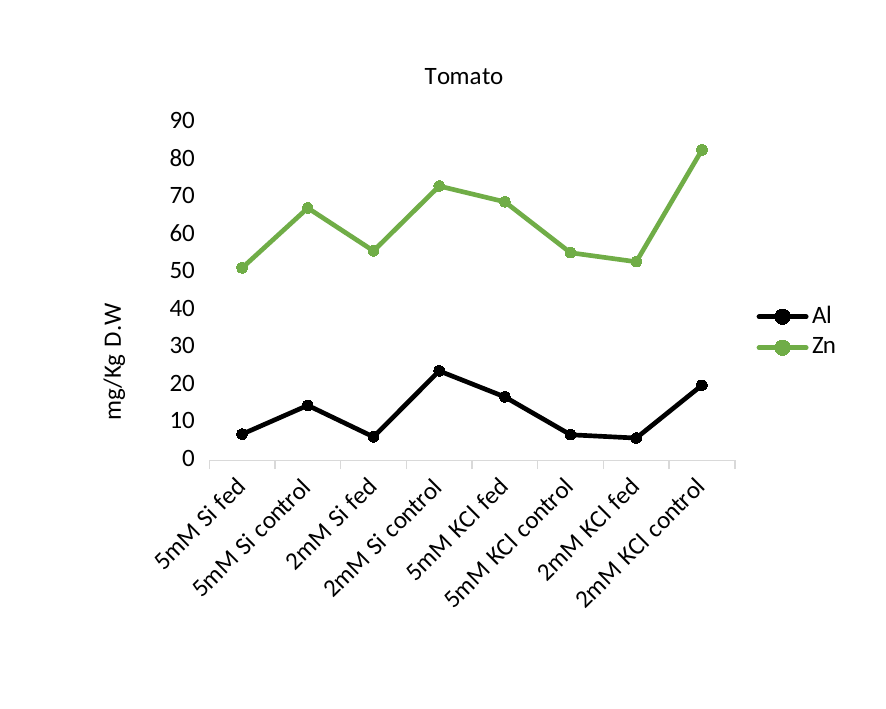
How many series does the legend list? 2 Is the Zn value for 2mM KCl control greater or less than 70? greater For which category is the Al value highest? 2mM Si control Is the Al value for 2mM Si control greater or less than 20? greater Does the Al value rise or fall from 2mM Si control to 5mM KCl control? fall How many categories are shown on the x axis? 8 What kind of chart is shown on the slide? line chart What is the title of the chart? Tomato What is the y-axis label of the chart? mg/Kg D.W Which is larger, the Zn value for 5mM Si control or the Zn value for 2mM Si fed? 5mM Si control For which category is the Zn value highest? 2mM KCl control Is the Zn value for 5mM Si fed greater or less than 60? less